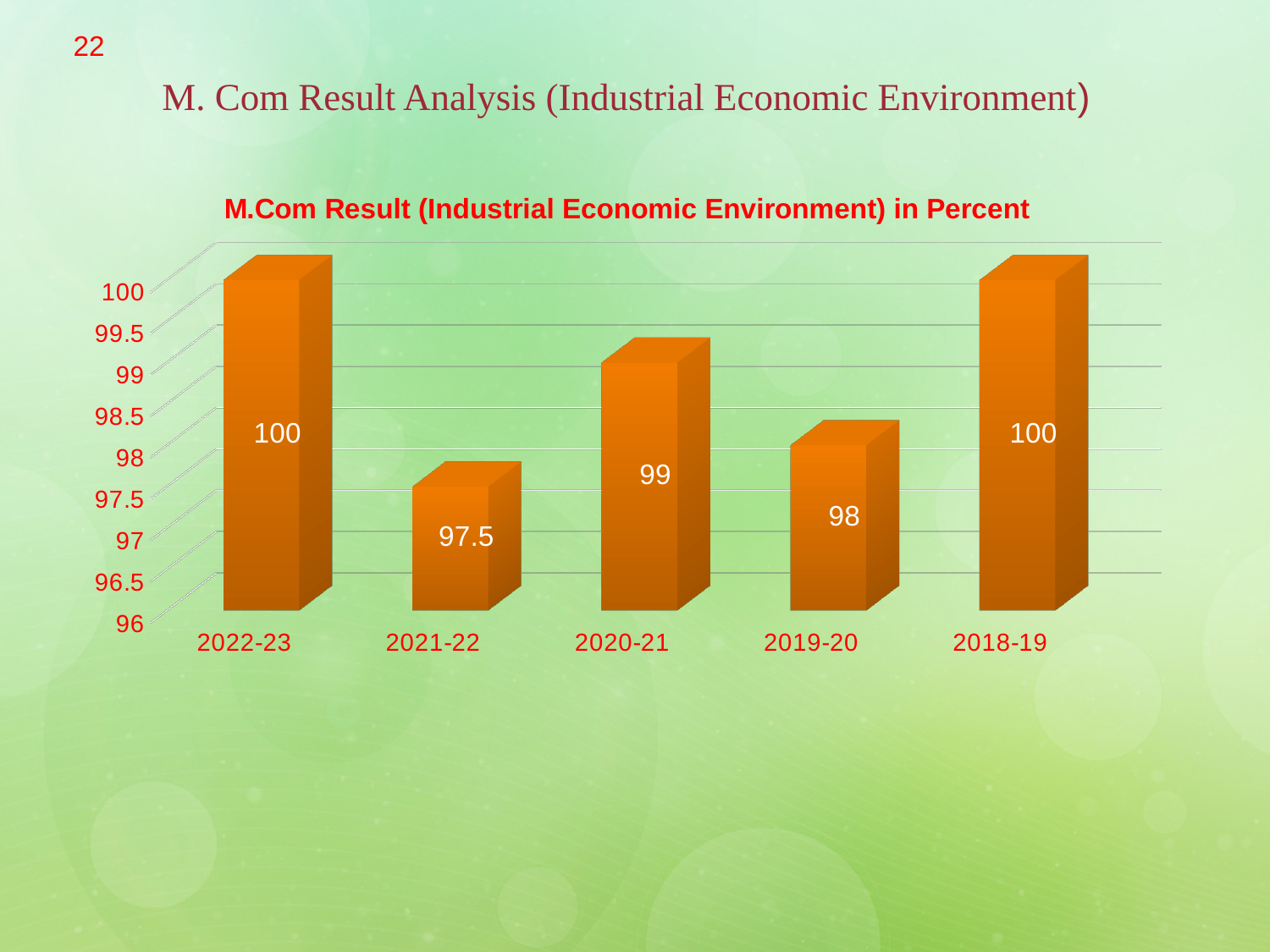
Which year has the lowest value? 2021-22 How many years are shown on the chart? 5 What is the value for 2019-20? 98 Is the value for 2021-22 greater or less than 98? less What is the difference between the values for 2018-19 and 2019-20? 2 What kind of chart is shown on the slide? bar chart What is the value for 2021-22? 97.5 Which is larger, the value for 2020-21 or the value for 2019-20? 2020-21 What is the difference between the values for 2020-21 and 2021-22? 1.5 What is the value for 2020-21? 99 What is the title of the chart? M.Com Result (Industrial Economic Environment) in Percent What is the value for 2022-23? 100